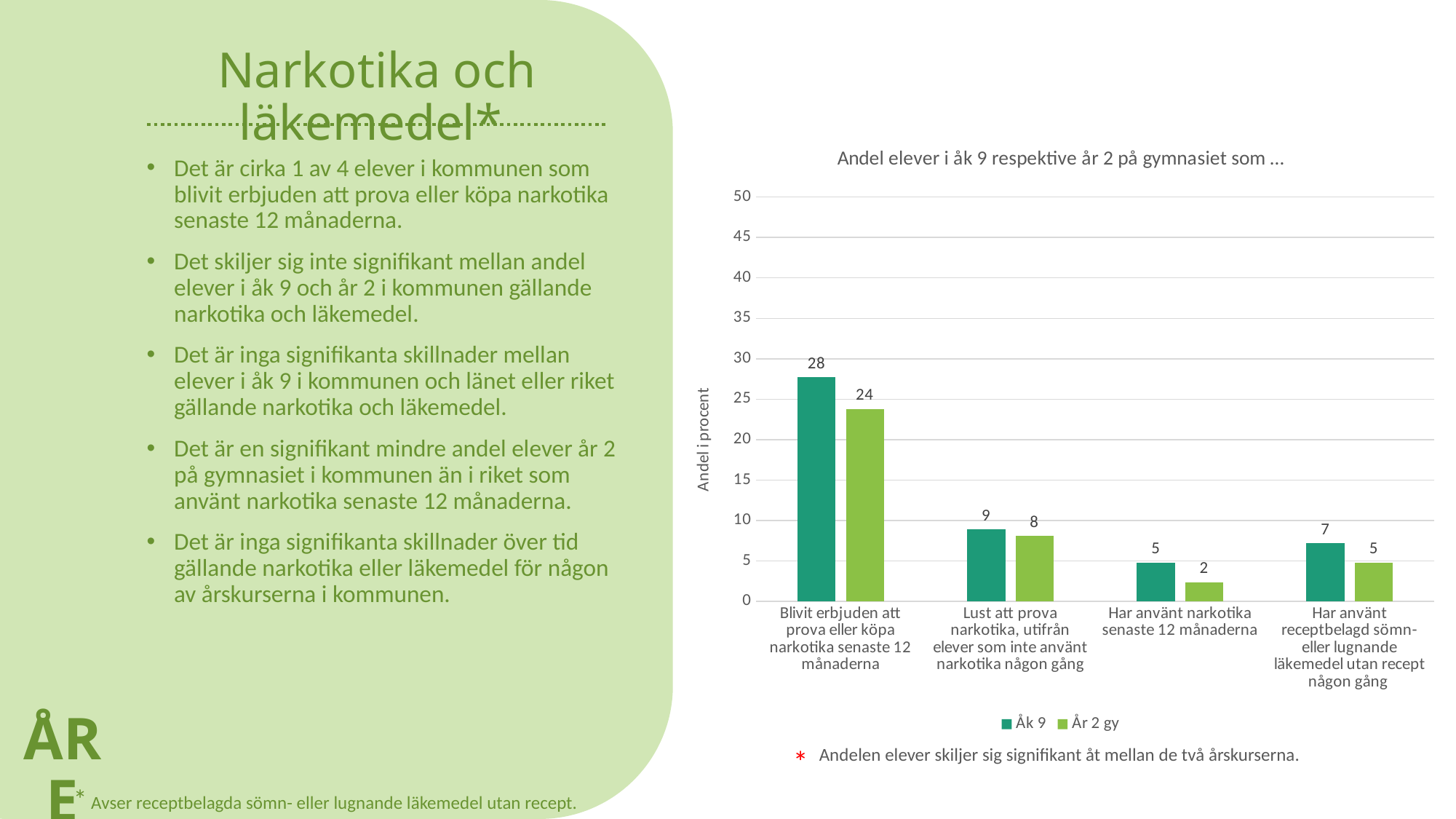
What kind of chart is shown on the slide? Bar chart What is the difference between Åk 9 and År 2 gy in the category 'Blivit erbjuden att prova eller köpa narkotika senaste 12 månaderna'? 4 Which category has the highest value for Åk 9? Blivit erbjuden att prova eller köpa narkotika senaste 12 månaderna Which category has the lowest value for År 2 gy? Har använt narkotika senaste 12 månaderna Which series has the larger value in the category 'Har använt receptbelagd sömn- eller lugnande läkemedel utan recept någon gång', Åk 9 or År 2 gy? Åk 9 What is the value for Åk 9 in the category 'Blivit erbjuden att prova eller köpa narkotika senaste 12 månaderna'? 28 How many series does the chart legend list? 2 Is the value for Åk 9 in the category 'Blivit erbjuden att prova eller köpa narkotika senaste 12 månaderna' greater or less than 25? greater What is the value for År 2 gy in the category 'Har använt narkotika senaste 12 månaderna'? 2 How many categories are shown on the x axis of the chart? 4 What is the label of the vertical axis of the chart? Andel i procent What is the value for År 2 gy in the category 'Lust att prova narkotika, utifrån elever som inte använt narkotika någon gång'? 8